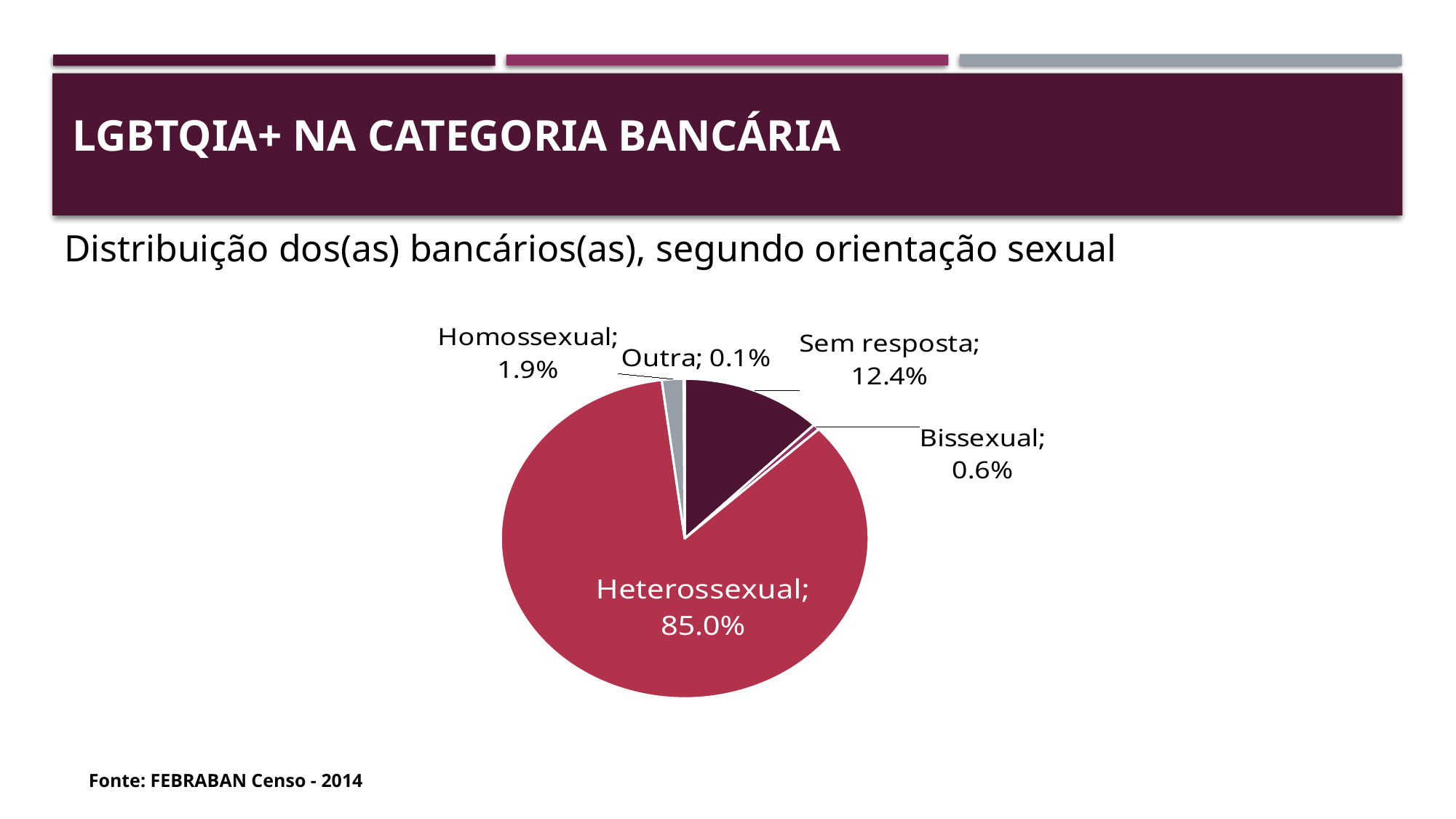
Which category has the largest slice of the pie? Heterossexual What is the value for Bissexual? 0.6% What type of chart is shown on the slide? pie chart Which is larger, the value for Homossexual or the value for Bissexual? Homossexual What is the source cited below the chart? FEBRABAN Censo - 2014 What is the value for Sem resposta? 12.4% What is the value for Homossexual? 1.9% What is the difference between the values for Heterossexual and Sem resposta? 72.6% How many categories are shown in the pie chart? 5 What is the value for Outra? 0.1% Which category has the smallest slice of the pie? Outra What share of the pie does Heterossexual represent? 85.0%